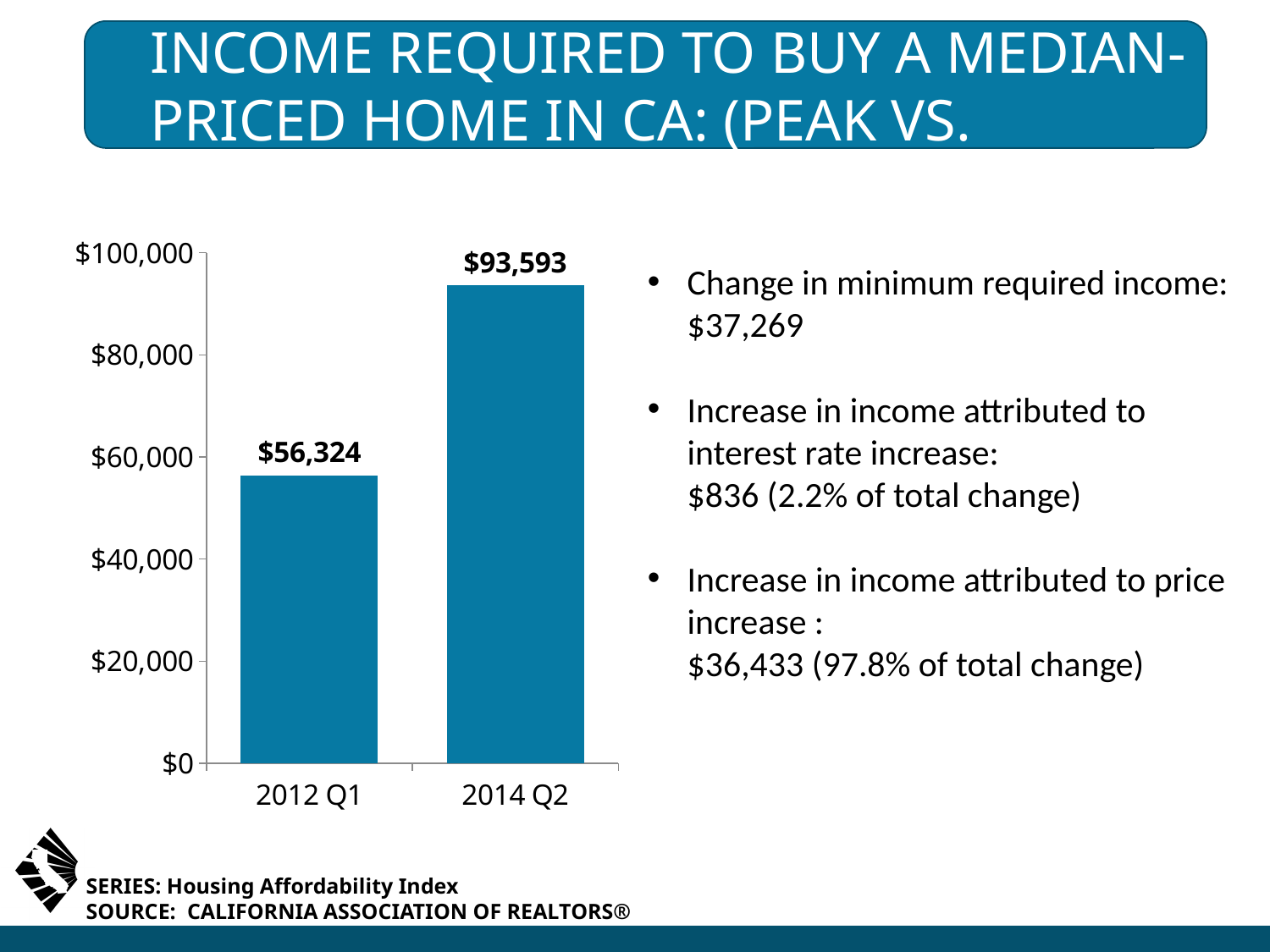
What is the income required to buy a median-priced home in 2014 Q2? $93,593 Is the value for 2014 Q2 greater or less than $80,000? greater Which period has the lower required income? 2012 Q1 What is the maximum value shown on the vertical axis of the chart? $100,000 Is the required income larger in 2012 Q1 or 2014 Q2? 2014 Q2 What is the income required to buy a median-priced home in 2012 Q1? $56,324 Do the values rise or fall from 2012 Q1 to 2014 Q2? rise What kind of chart is shown on the slide? bar chart Which period has the higher required income? 2014 Q2 How many periods are shown on the chart? 2 Is the value for 2012 Q1 greater or less than $60,000? less What is the difference between the required income in 2014 Q2 and 2012 Q1? $37,269